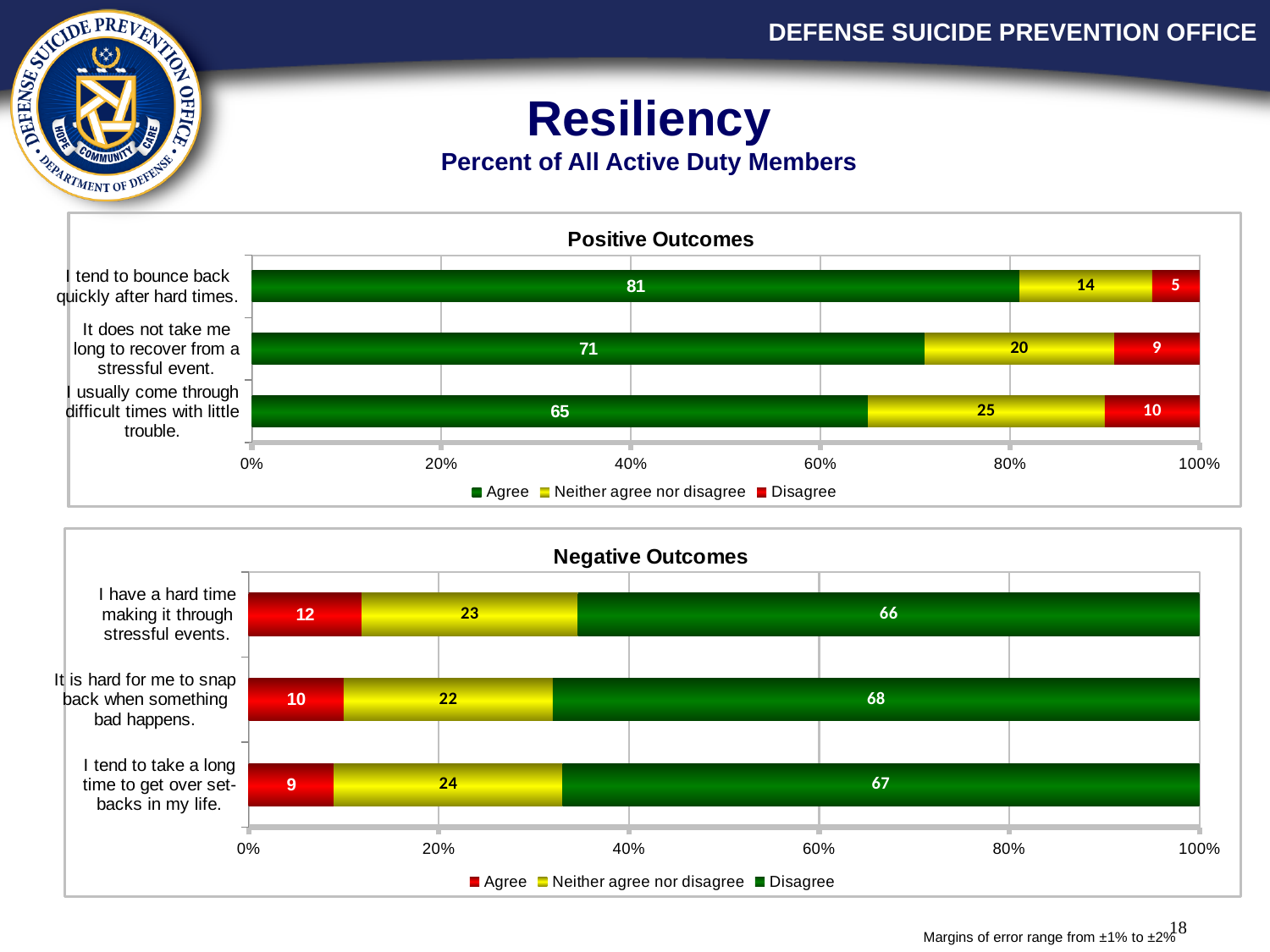
In the Positive Outcomes chart, what percent disagree with "It does not take me long to recover from a stressful event."? 9 In the Positive Outcomes chart, what percent agree with "I tend to bounce back quickly after hard times."? 81 How many statements are shown in the Negative Outcomes chart? 3 In the Negative Outcomes chart, is the Disagree value for "I have a hard time making it through stressful events." larger than the Agree value for the same statement? Yes In the Negative Outcomes chart, what percent neither agree nor disagree with "I tend to take a long time to get over set-backs in my life."? 24 In the Positive Outcomes chart, what is the difference between the Agree values for "I tend to bounce back quickly after hard times." and "I usually come through difficult times with little trouble."? 16 In the Positive Outcomes chart, which statement has the highest Agree value? I tend to bounce back quickly after hard times. What kind of chart is the Positive Outcomes chart? Stacked bar chart In the Negative Outcomes chart, which statement has the lowest Agree value? I tend to take a long time to get over set-backs in my life. How many series does the legend of the Positive Outcomes chart list? 3 In the Negative Outcomes chart, what colour represents Agree? Red In the Negative Outcomes chart, which statement has the highest Disagree value? It is hard for me to snap back when something bad happens.